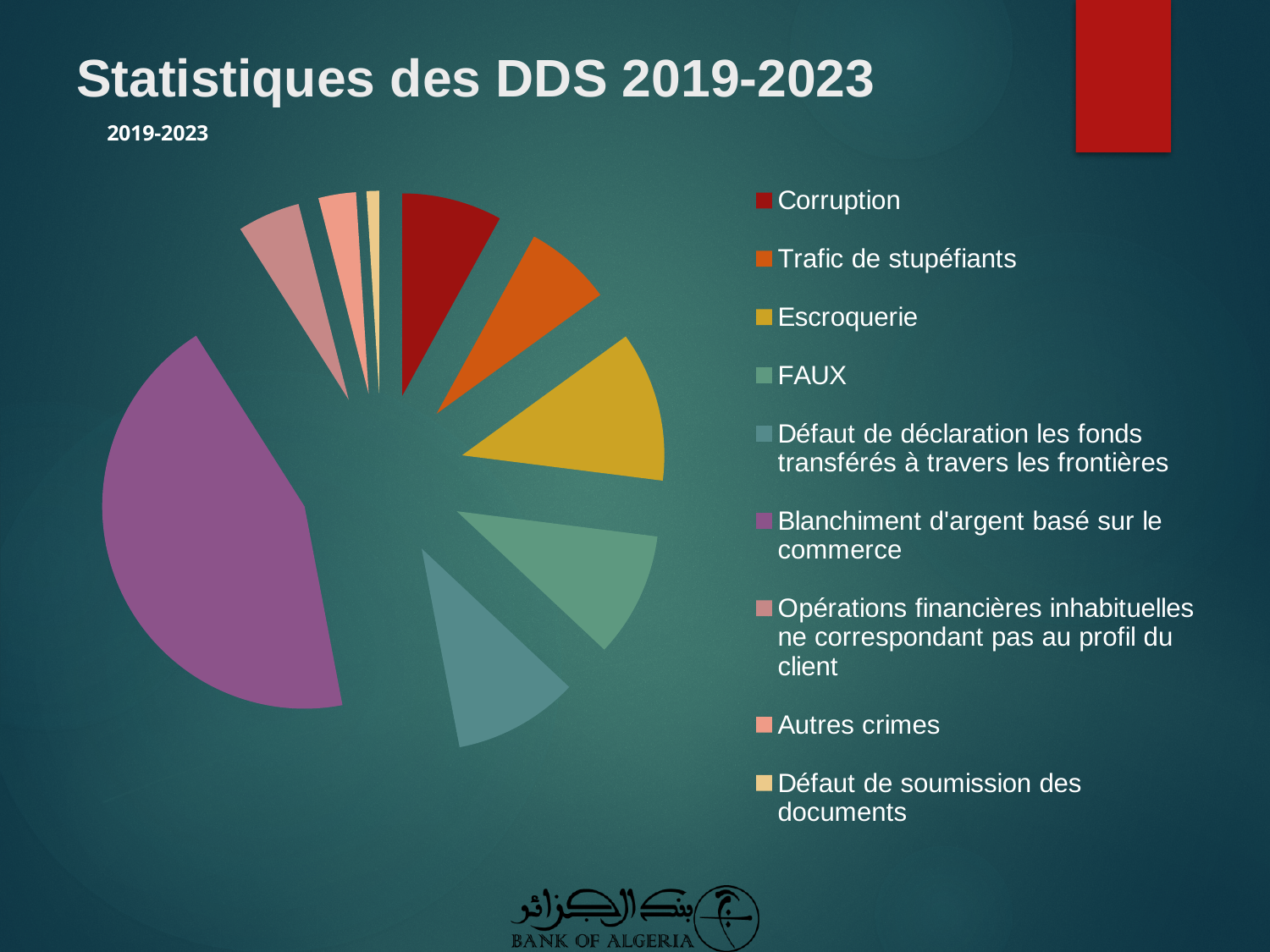
What colour is the slice for Blanchiment d'argent basé sur le commerce? purple Which slice is larger, Opérations financières inhabituelles ne correspondant pas au profil du client or Autres crimes? Opérations financières inhabituelles ne correspondant pas au profil du client Which slice is larger, Corruption or Autres crimes? Corruption Which slice is larger, Escroquerie or Trafic de stupéfiants? Escroquerie What kind of chart is shown on the slide? pie chart How many categories does the pie chart's legend list? 9 What is the title of the pie chart? 2019-2023 Which category has the largest slice of the pie chart? Blanchiment d'argent basé sur le commerce Which category has the smallest slice of the pie chart? Défaut de soumission des documents